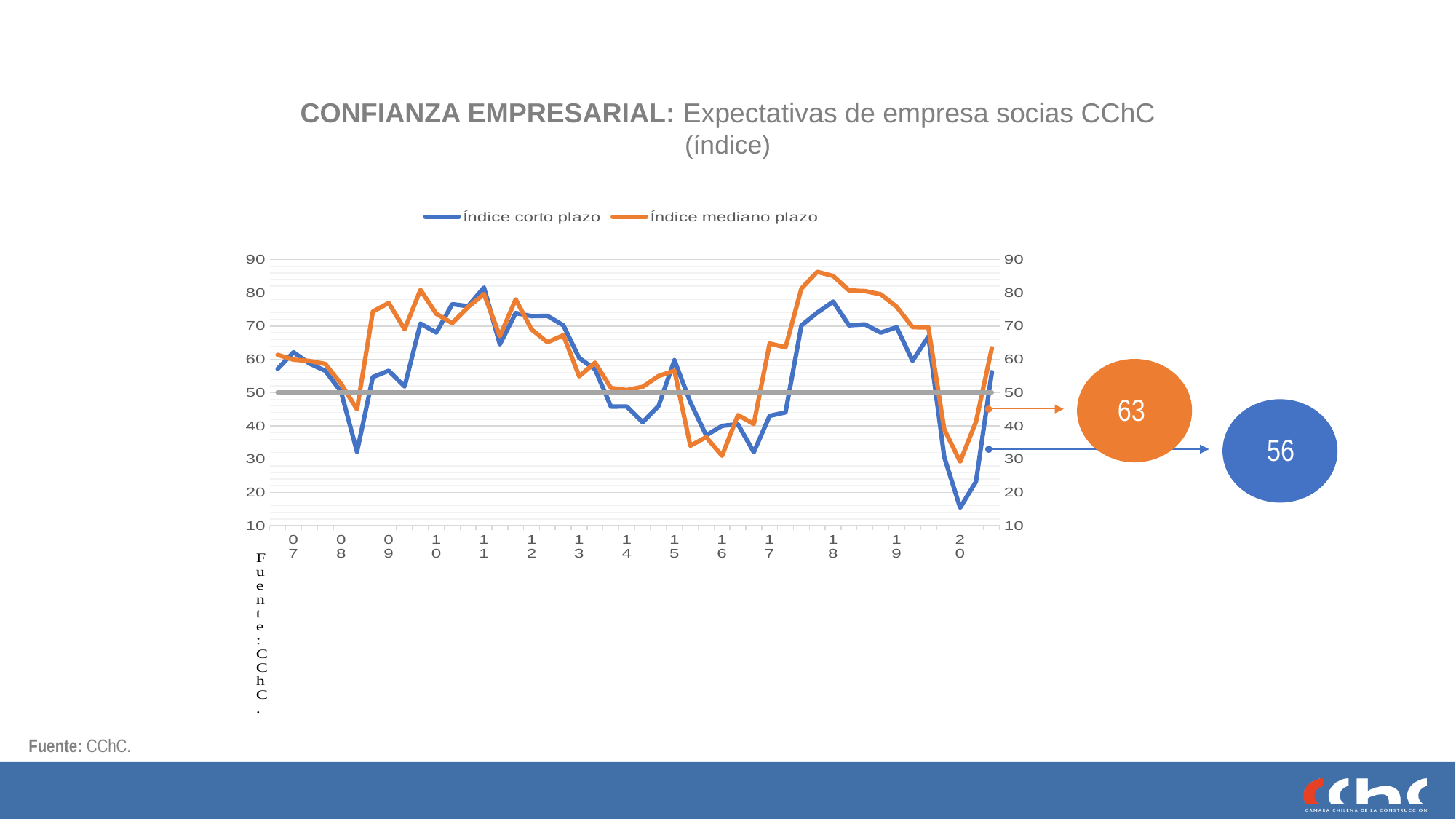
What is the latest value shown for Índice corto plazo (blue callout)? 56 What is the latest value shown for Índice mediano plazo (orange callout)? 63 Is the lowest value of Índice corto plazo in 2008 greater or less than 40? less What is the difference between the latest values of Índice mediano plazo (63) and Índice corto plazo (56)? 7 Is the peak value of Índice mediano plazo in 2018 greater or less than 80? greater At what level is the gray horizontal reference line drawn? 50 Which series has the higher latest value, Índice corto plazo or Índice mediano plazo? Índice mediano plazo Is the lowest value of Índice corto plazo in 2020 greater or less than 20? less What are the two series named in the legend? Índice corto plazo and Índice mediano plazo How many series does the legend list? 2 What kind of chart is shown on the slide? line chart How many year labels are shown on the x axis? 14